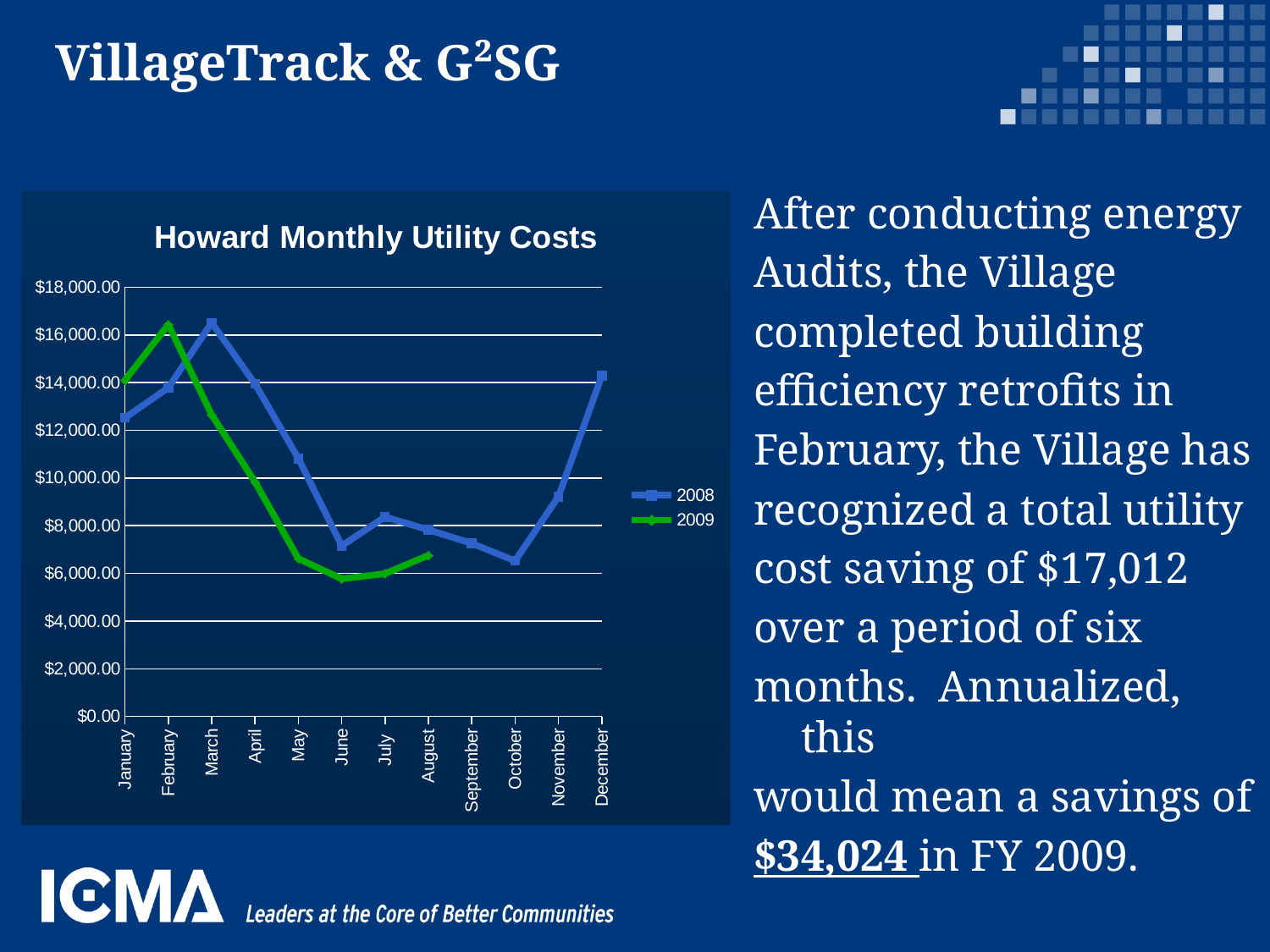
Is the 2009 value for May greater or less than $8,000.00? less Is the 2008 value for March greater or less than $16,000.00? greater In which month does the 2008 series reach its highest value? March How many series does the chart's legend list? 2 How many months are labelled along the x axis of the chart? 12 In which month does the 2008 series reach its lowest value? October What is the title of the chart? Howard Monthly Utility Costs In March, which series has the higher value, 2008 or 2009? 2008 Does the 2009 series rise or fall from February to June? Fall In which month does the 2009 series reach its highest value? February Which colour is used for the 2009 series in the chart? Green What kind of chart is shown on the slide? Line chart